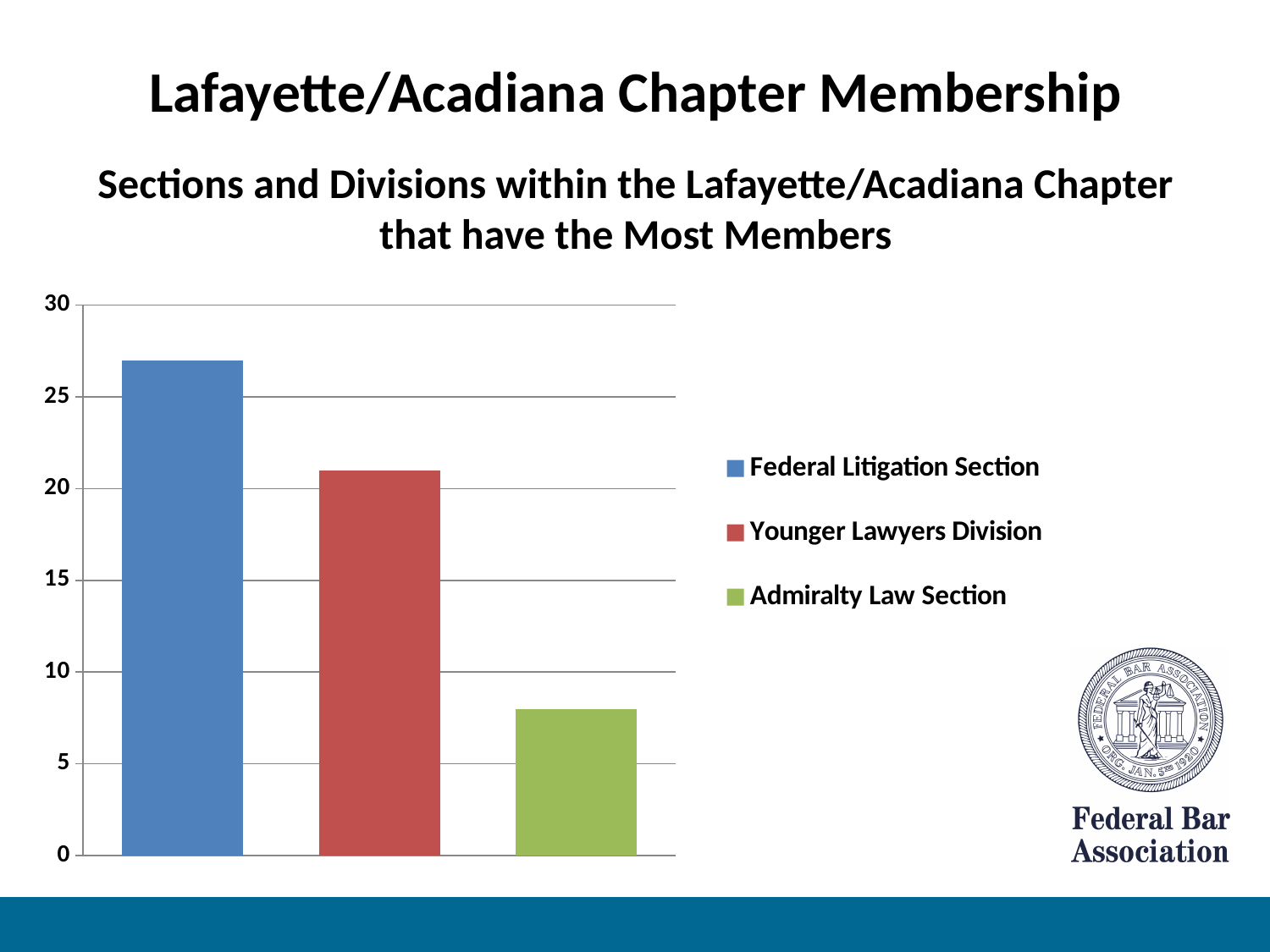
Is the value for the Federal Litigation Section greater or less than 25? greater Is the value for the Admiralty Law Section greater or less than 10? less How many series does the legend list? 3 Which section or division has the highest number of members? Federal Litigation Section Which has more members, the Younger Lawyers Division or the Admiralty Law Section? Younger Lawyers Division How many bars are plotted in the chart? 3 Which section or division has the lowest number of members? Admiralty Law Section Is the value for the Younger Lawyers Division greater or less than 20? greater What colour is the bar for the Admiralty Law Section? green What kind of chart is shown on the slide? bar chart Which has more members, the Federal Litigation Section or the Younger Lawyers Division? Federal Litigation Section